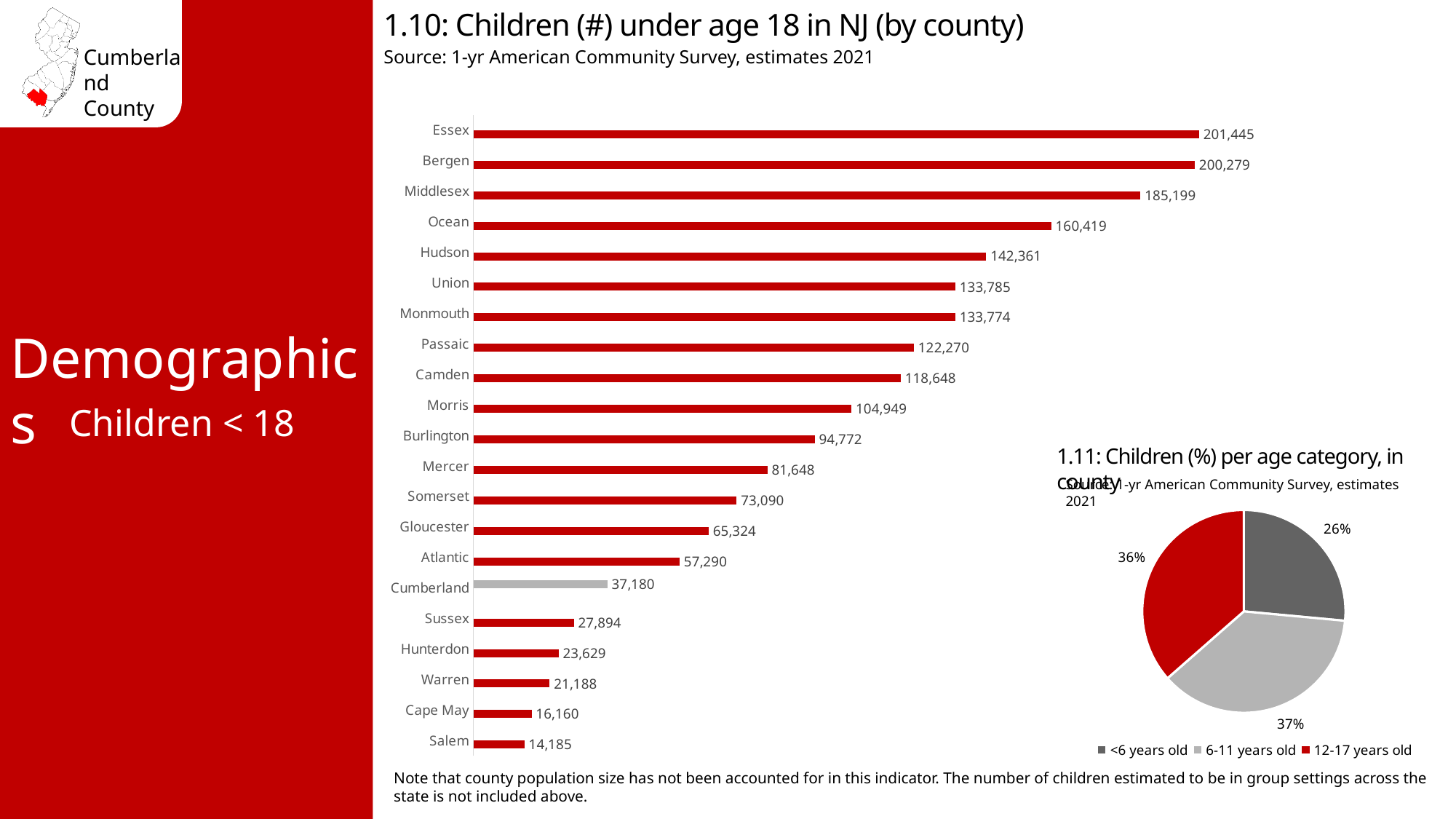
In the pie chart '1.11: Children (%) per age category, in county', what share is '<6 years old'? 26% In the chart '1.10: Children (#) under age 18 in NJ (by county)', what is the value for Ocean? 160,419 How many counties are shown in the chart '1.10: Children (#) under age 18 in NJ (by county)'? 21 How many categories does the legend of the pie chart '1.11: Children (%) per age category, in county' list? 3 What kind of chart is '1.10: Children (#) under age 18 in NJ (by county)'? Bar chart In the chart '1.10: Children (#) under age 18 in NJ (by county)', which county has the lowest value? Salem In the chart '1.10: Children (#) under age 18 in NJ (by county)', what is the difference between the values for Essex and Bergen? 1,166 In the chart '1.10: Children (#) under age 18 in NJ (by county)', which is larger, the value for Hudson or the value for Union? Hudson In the pie chart '1.11: Children (%) per age category, in county', which age category has the largest share? 6-11 years old In the chart '1.10: Children (#) under age 18 in NJ (by county)', which county has the highest value? Essex In the chart '1.10: Children (#) under age 18 in NJ (by county)', how much larger is the value for Atlantic than the value for Cumberland? 20,110 In the chart '1.10: Children (#) under age 18 in NJ (by county)', what is the value for Cumberland? 37,180